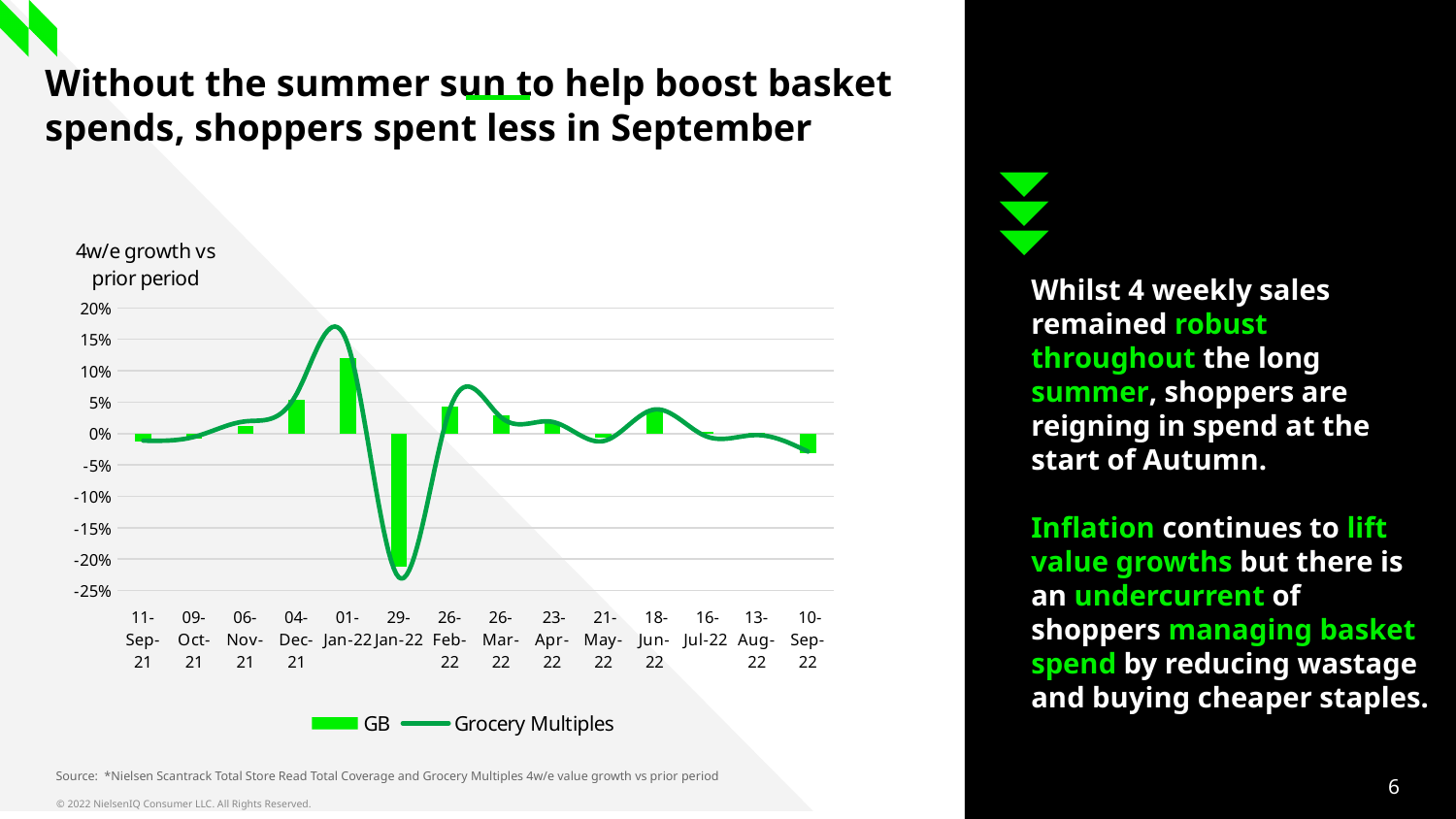
What is the title of the chart? 4w/e growth vs prior period Which series is plotted as bars in the chart? GB How many time periods are shown on the x axis of the chart? 14 Is the GB value for 29-Jan-22 greater or less than -10%? less What kind of chart is shown on the slide? A combined bar and line chart Which has the larger GB value, 06-Nov-21 or 04-Dec-21? 04-Dec-21 Does the GB value rise or fall from 01-Jan-22 to 29-Jan-22? fall How many series does the chart legend list? 2 In which period is the GB bar at its highest? 01-Jan-22 Is the GB value for 01-Jan-22 greater or less than 5%? greater Is the Grocery Multiples value for 01-Jan-22 greater or less than 10%? greater In which period is the GB bar at its lowest? 29-Jan-22